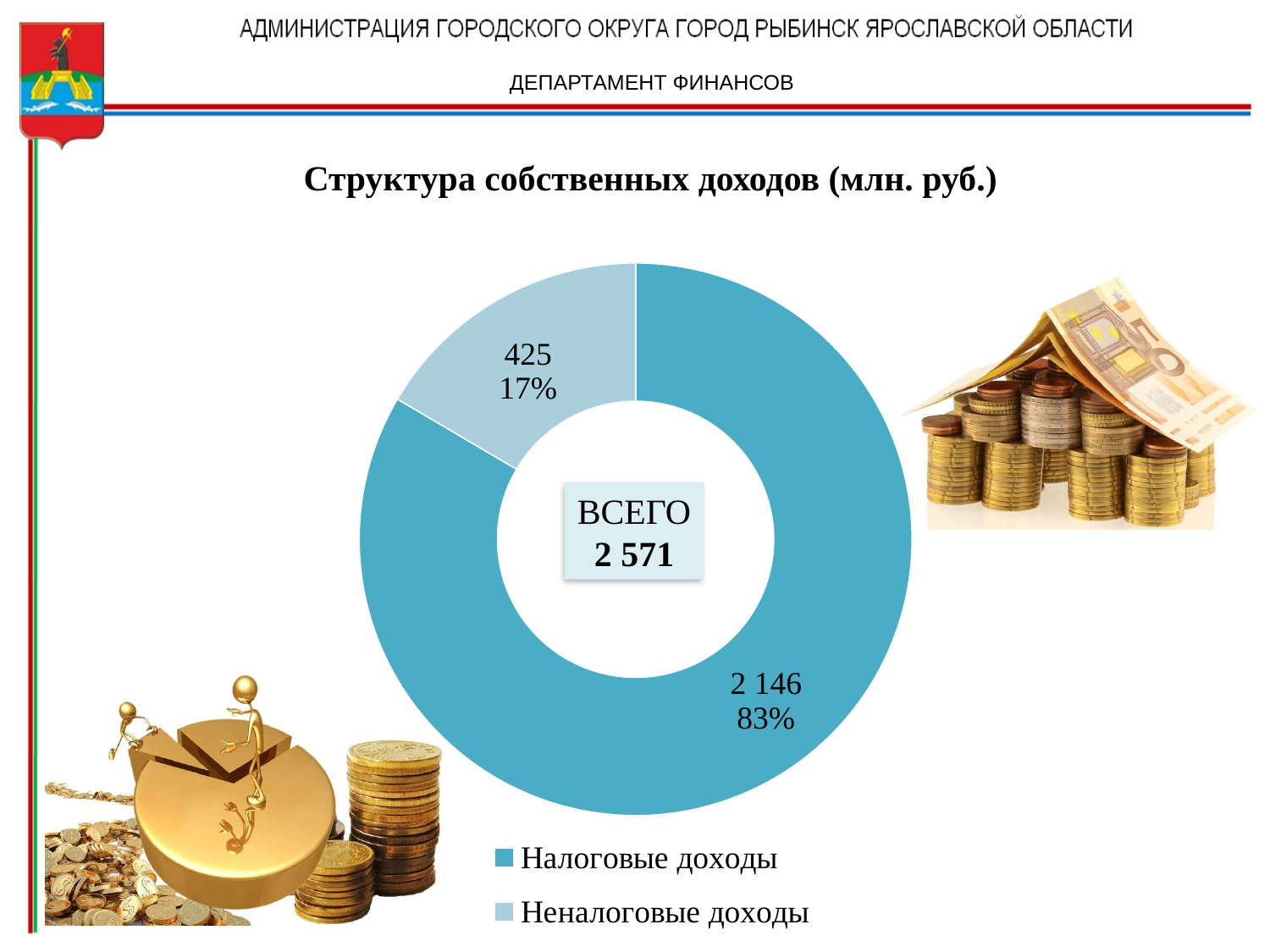
What is the value for Неналоговые доходы? 425 Which category has the largest slice? Налоговые доходы What kind of chart is shown on the slide? Pie chart (doughnut) What total (ВСЕГО) is shown in the centre of the chart? 2 571 How many categories does the pie chart have? 2 What share of the pie does Неналоговые доходы take? 17% What is the title of the chart? Структура собственных доходов (млн. руб.) What is the value for Налоговые доходы? 2 146 Which category has the smallest slice? Неналоговые доходы What is the difference between Налоговые доходы and Неналоговые доходы? 1 721 Which is larger, Налоговые доходы or Неналоговые доходы? Налоговые доходы What share of the pie does Налоговые доходы take? 83%